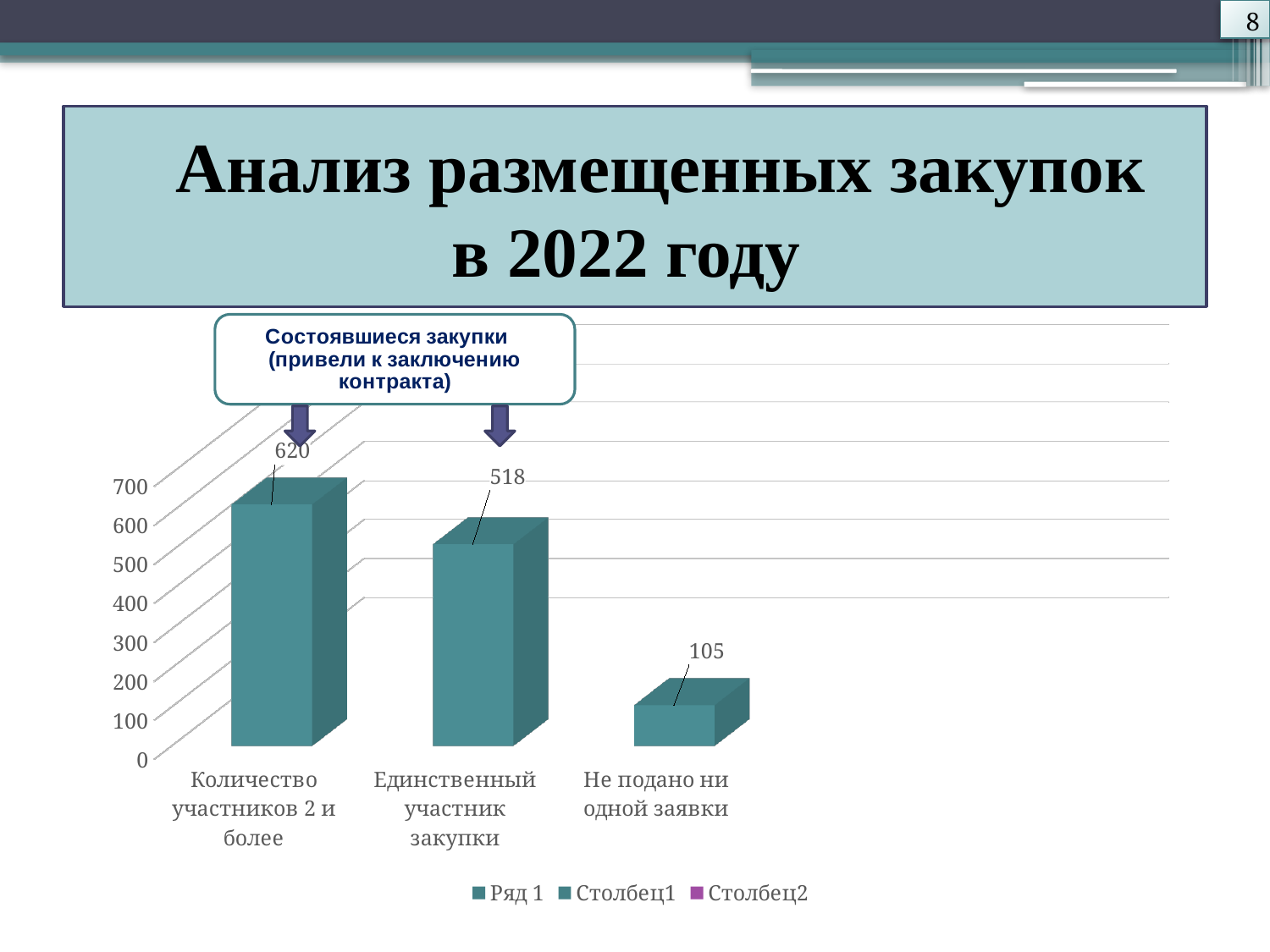
What kind of chart is shown on the slide? bar chart Which category has the lowest value? Не подано ни одной заявки Which is larger: the value for "Единственный участник закупки" or for "Не подано ни одной заявки"? Единственный участник закупки Which category has the highest value? Количество участников 2 и более Is the value for "Не подано ни одной заявки" greater or less than 200? less What is the value for "Не подано ни одной заявки"? 105 What is the difference between the values for "Единственный участник закупки" and "Не подано ни одной заявки"? 413 What is the difference between the values for "Количество участников 2 и более" and "Единственный участник закупки"? 102 How many series does the legend list? 3 What is the value for "Единственный участник закупки"? 518 How many categories are shown on the x axis? 3 What is the value for "Количество участников 2 и более"? 620